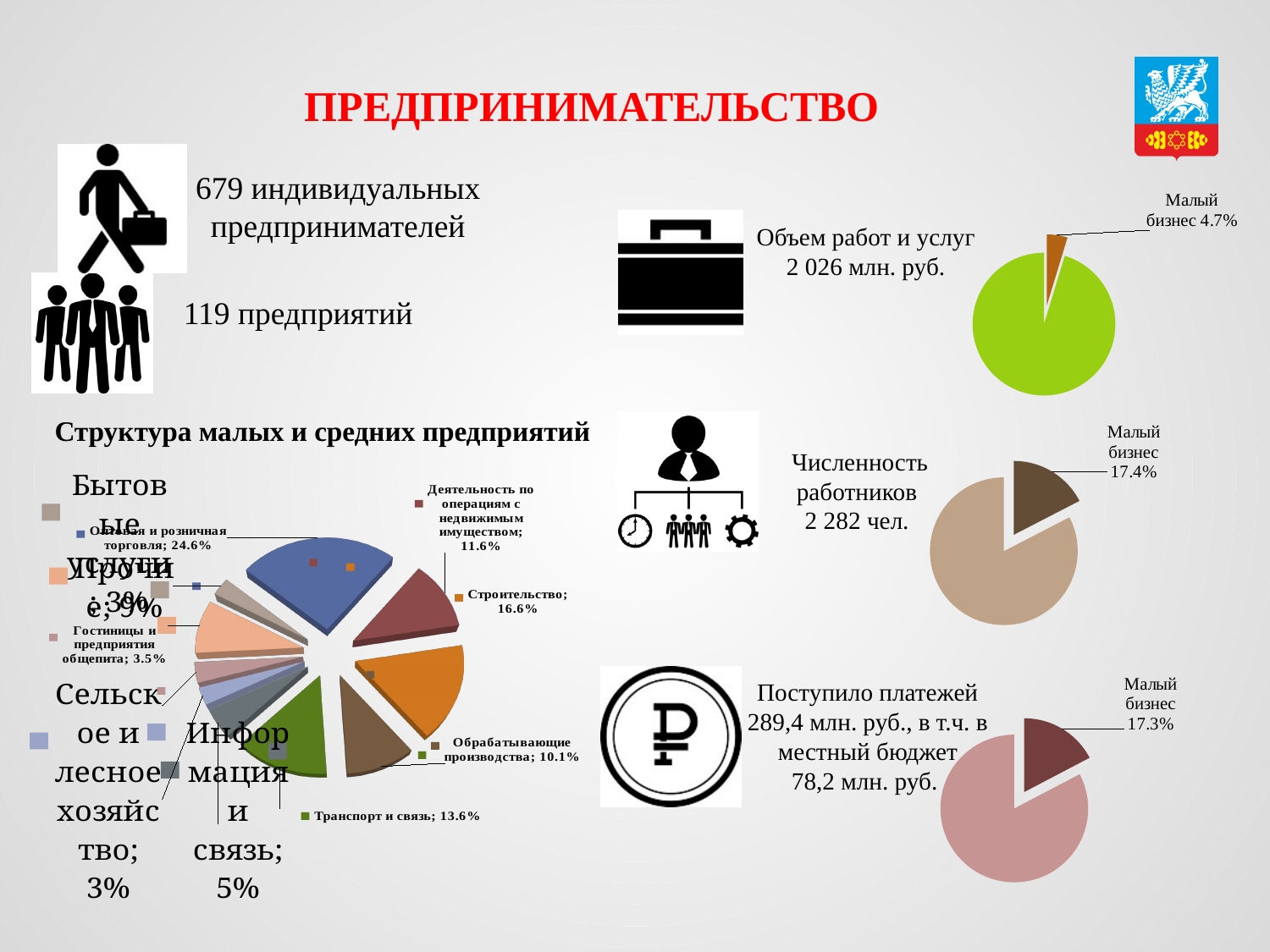
In the pie chart 'Структура малых и средних предприятий', what share is labelled for 'Строительство'? 16.6% In the pie chart 'Структура малых и средних предприятий', which is larger: 'Строительство' or 'Деятельность по операциям с недвижимым имуществом'? Строительство In the pie chart next to 'Поступило платежей', what share is labelled for 'Малый бизнес'? 17.3% In the pie chart 'Структура малых и средних предприятий', which labelled sector has the largest share? Оптовая и розничная торговля What type of chart is used for 'Структура малых и средних предприятий'? Pie chart In the pie chart 'Структура малых и средних предприятий', what is the difference between the shares of 'Оптовая и розничная торговля' and 'Строительство'? 8.0 percentage points In the pie chart 'Структура малых и средних предприятий', what share is labelled for 'Оптовая и розничная торговля'? 24.6% In the pie chart 'Структура малых и средних предприятий', what share is labelled for 'Гостиницы и предприятия общепита'? 3.5% In the pie chart next to 'Объем работ и услуг', what share is labelled for 'Малый бизнес'? 4.7% In the pie chart next to 'Численность работников', what share is labelled for 'Малый бизнес'? 17.4% In the pie chart 'Структура малых и средних предприятий', what share is labelled for 'Обрабатывающие производства'? 10.1% In the pie chart 'Структура малых и средних предприятий', what share is labelled for 'Транспорт и связь'? 13.6%